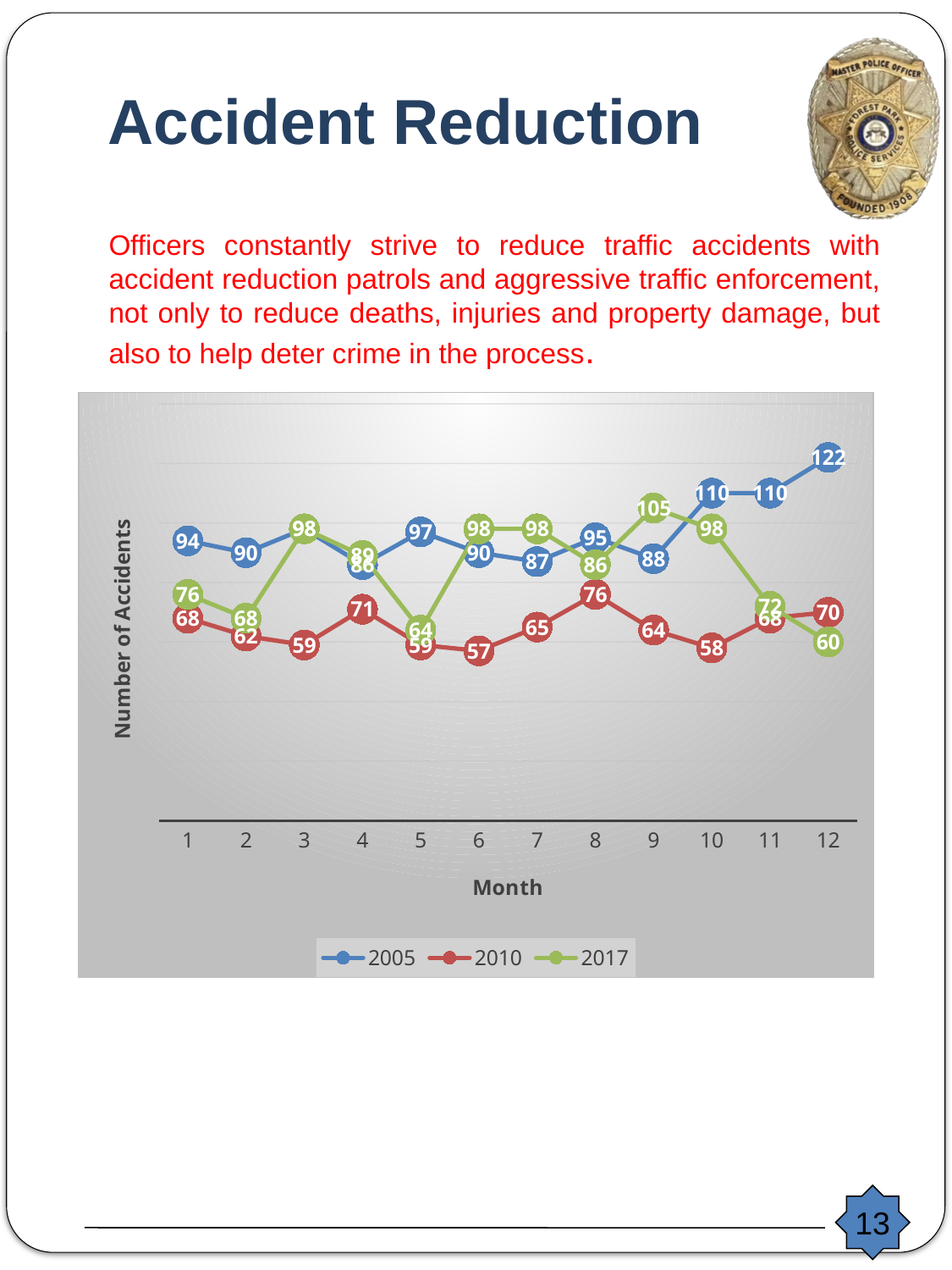
In which month does the 2010 series have its lowest value? 6 What is the difference between the 2005 and 2010 values in month 12? 52 What kind of chart is shown on the slide? Line chart In which month does the 2017 series have its lowest value? 12 What is the title of the vertical axis? Number of Accidents How many months are plotted on the x axis? 12 In which month does the 2005 series reach its highest value? 12 In month 9, which series has the higher value, 2005 or 2017? 2017 What is the number of accidents in month 9 for the 2017 series? 105 How many series does the legend list? 3 What is the number of accidents in month 12 for the 2005 series? 122 What is the number of accidents in month 6 for the 2010 series? 57